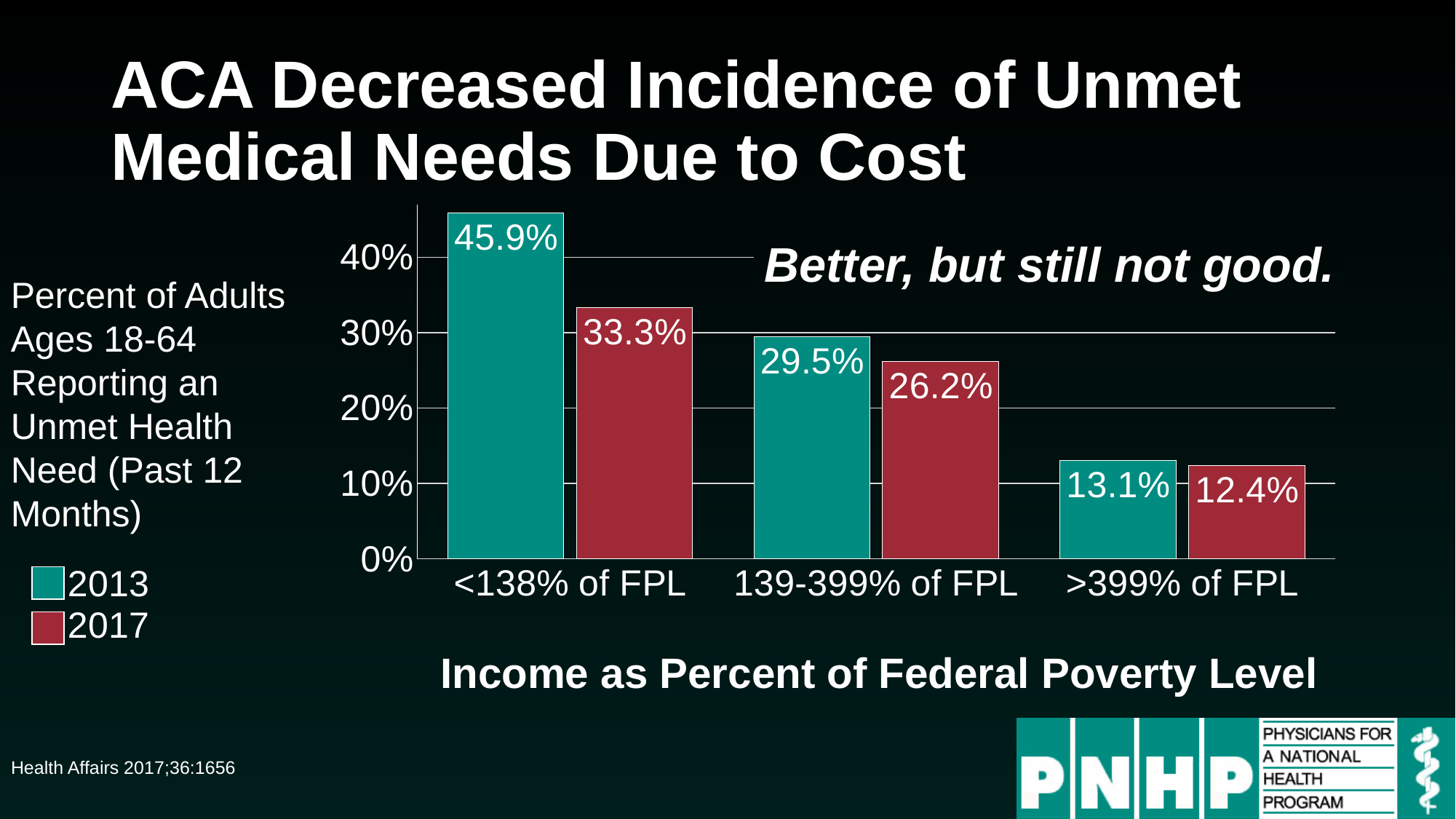
What was the 2017 value for the 139-399% of FPL group? 26.2% How many series does the legend list? 2 Which income group had the lowest value in 2017? >399% of FPL What kind of chart is shown on the slide? Bar chart Which income group had the highest value in 2013? <138% of FPL What is the difference between the 2013 values for the 139-399% of FPL group and the >399% of FPL group? 16.4 percentage points How many income groups are shown on the x axis? 3 Do the 2013 values rise or fall as income moves from <138% of FPL to >399% of FPL? Fall By how many percentage points did the value for the <138% of FPL group fall from 2013 to 2017? 12.6 percentage points What was the percent of adults reporting an unmet health need in 2013 for the <138% of FPL group? 45.9% What was the 2017 value for the >399% of FPL group? 12.4% Which is larger: the 2017 value for <138% of FPL or the 2013 value for 139-399% of FPL? 2017 value for <138% of FPL